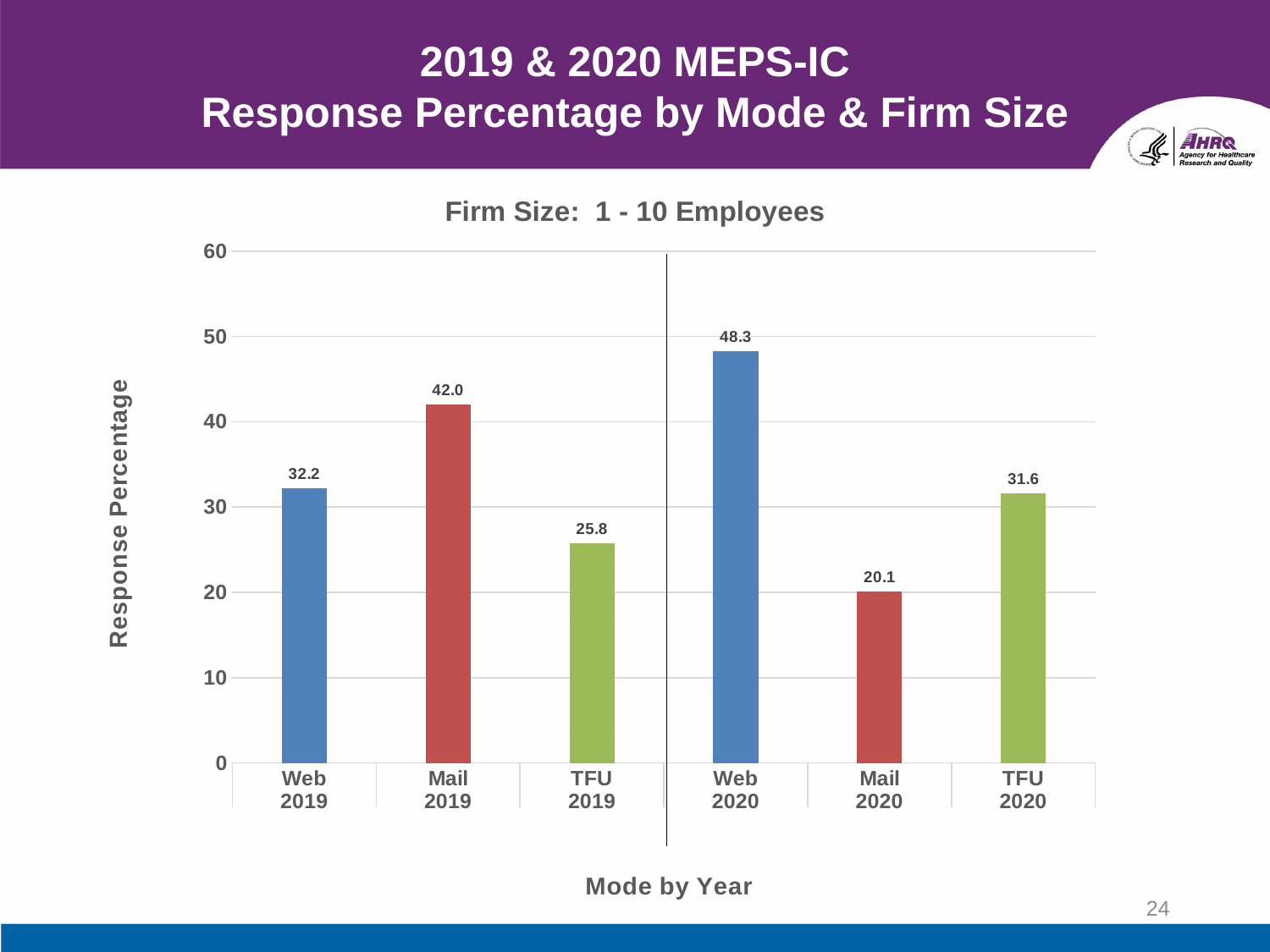
Which has a higher response percentage, TFU 2019 or TFU 2020? TFU 2020 What is the difference between the response percentages for Web 2020 and Web 2019? 16.1 What is the response percentage for TFU 2020? 31.6 Which mode-year category has the highest response percentage? Web 2020 What is the response percentage for Mail 2020? 20.1 What kind of chart is shown on the slide? Bar chart What is the title of the chart? Firm Size: 1 - 10 Employees Is the value for Mail 2019 greater or less than 40? greater Which mode-year category has the lowest response percentage? Mail 2020 What is the difference between the response percentages for Mail 2019 and Mail 2020? 21.9 What is the response percentage for Web 2019? 32.2 How many bars are shown in the chart? 6